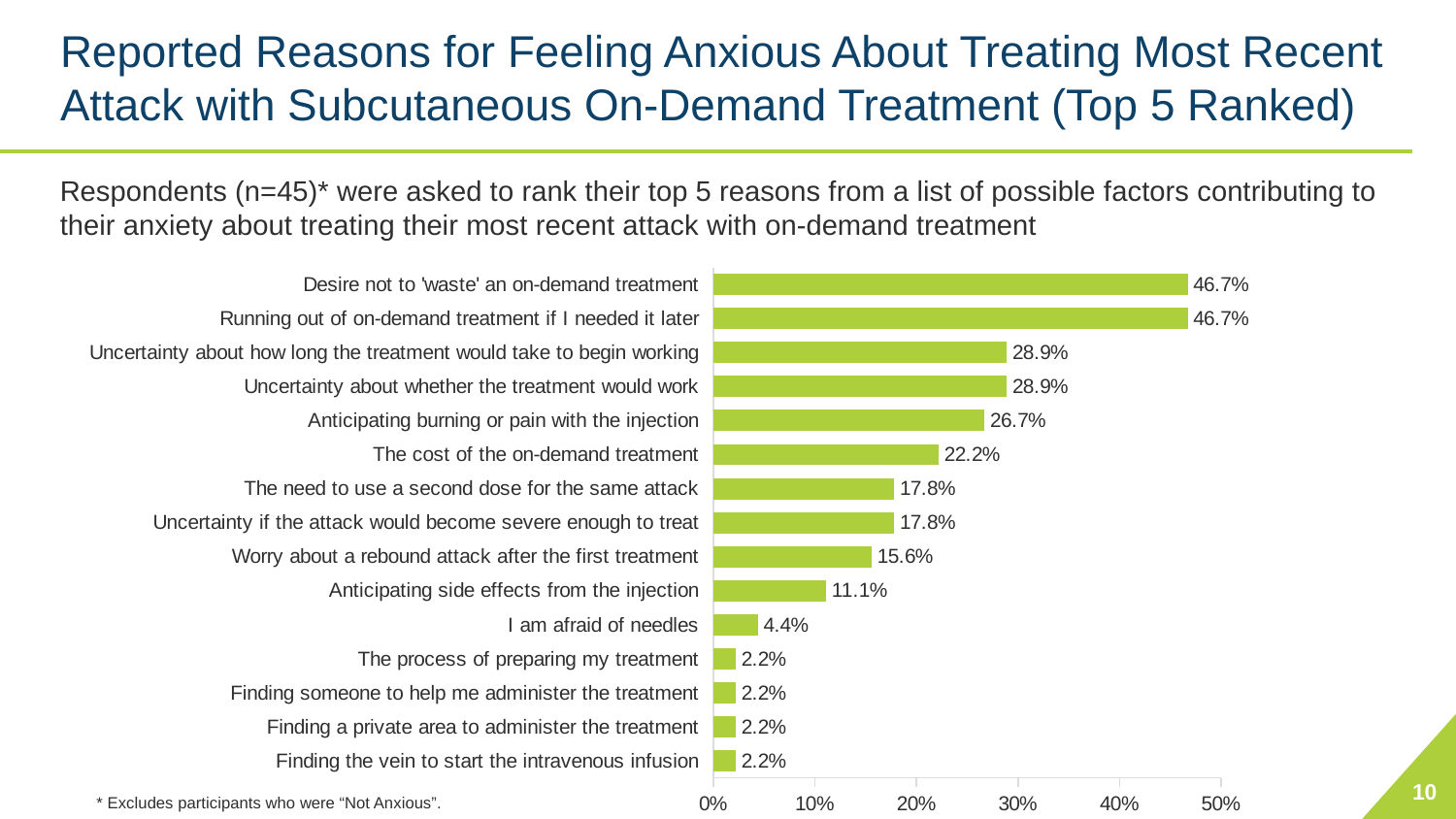
What is the lowest percentage shown on the chart? 2.2% What type of chart is shown on the slide? Bar chart What is the value for 'Anticipating burning or pain with the injection'? 26.7% What is the highest percentage shown on the chart? 46.7% Is the value for 'The need to use a second dose for the same attack' greater or less than 20%? less What is the value for 'Worry about a rebound attack after the first treatment'? 15.6% What is the difference between 'Running out of on-demand treatment if I needed it later' and 'Uncertainty about whether the treatment would work'? 17.8% What percentage of respondents cited 'Desire not to 'waste' an on-demand treatment' as a reason? 46.7% What is the value for 'I am afraid of needles'? 4.4% What is the difference between 'Anticipating side effects from the injection' and 'I am afraid of needles'? 6.7% Which has a larger value: 'The cost of the on-demand treatment' or 'Anticipating burning or pain with the injection'? Anticipating burning or pain with the injection How many reasons (categories) are shown on the chart? 15